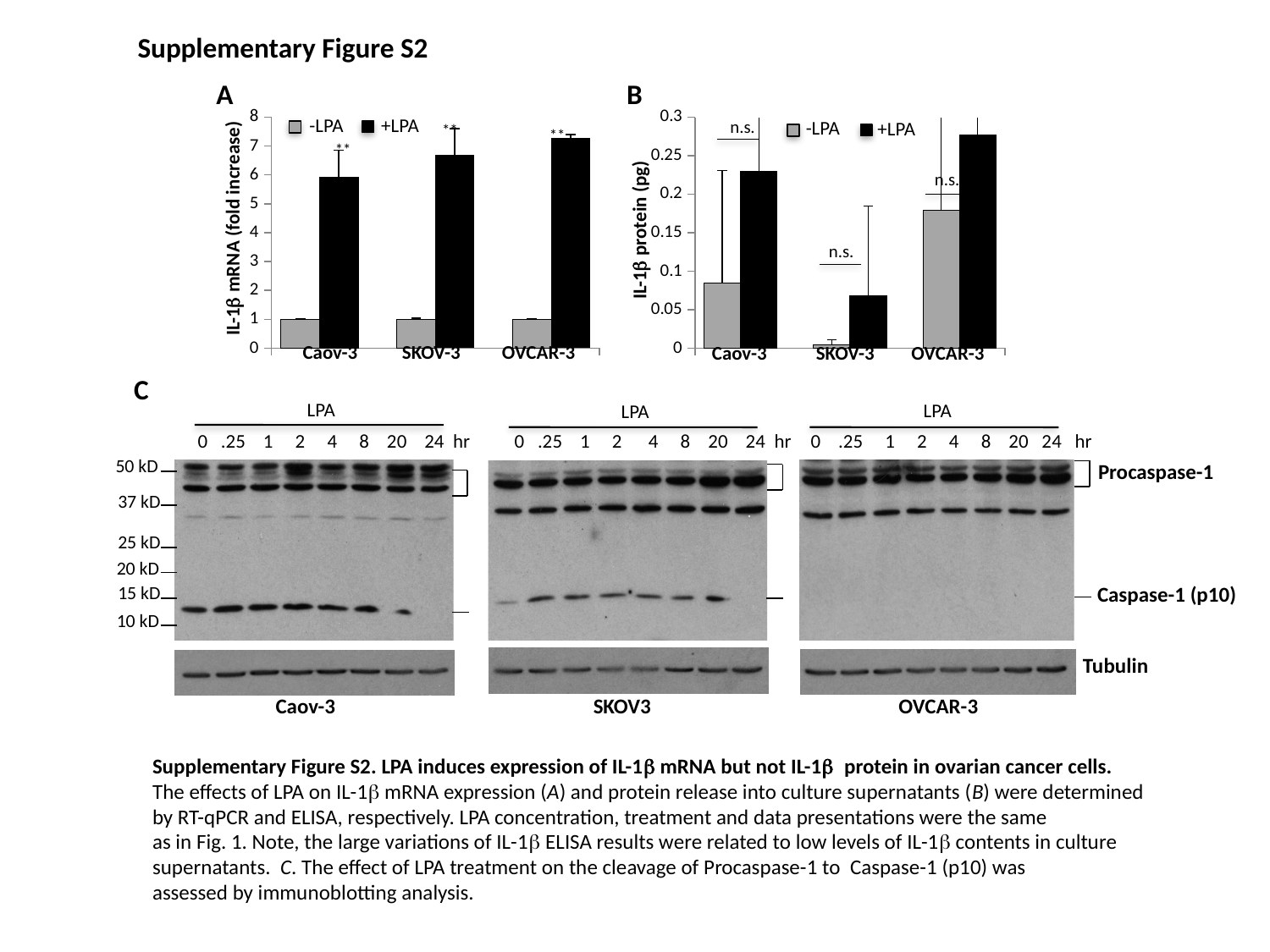
In chart A (IL-1β mRNA), how many series does the legend list? 2 In chart A (IL-1β mRNA), which cell line has the lowest +LPA value? Caov-3 In chart B (IL-1β protein), is the -LPA value for OVCAR-3 greater or less than 0.15? greater In chart A (IL-1β mRNA), is the +LPA value for SKOV-3 greater or less than 6? greater In chart A (IL-1β mRNA), how many cell lines are shown on the x axis? 3 In chart B (IL-1β protein), which cell line has the highest +LPA value? OVCAR-3 In chart A (IL-1β mRNA), what kind of chart is shown? bar chart In chart B, what is the y-axis title? IL-1β protein (pg) In chart B (IL-1β protein), which cell line has the lowest -LPA value? SKOV-3 In chart A (IL-1β mRNA), is the +LPA value for Caov-3 greater or less than 5? greater In chart A (IL-1β mRNA), which cell line has the highest +LPA value? OVCAR-3 In chart A (IL-1β mRNA), for Caov-3, which is larger: the -LPA value or the +LPA value? +LPA